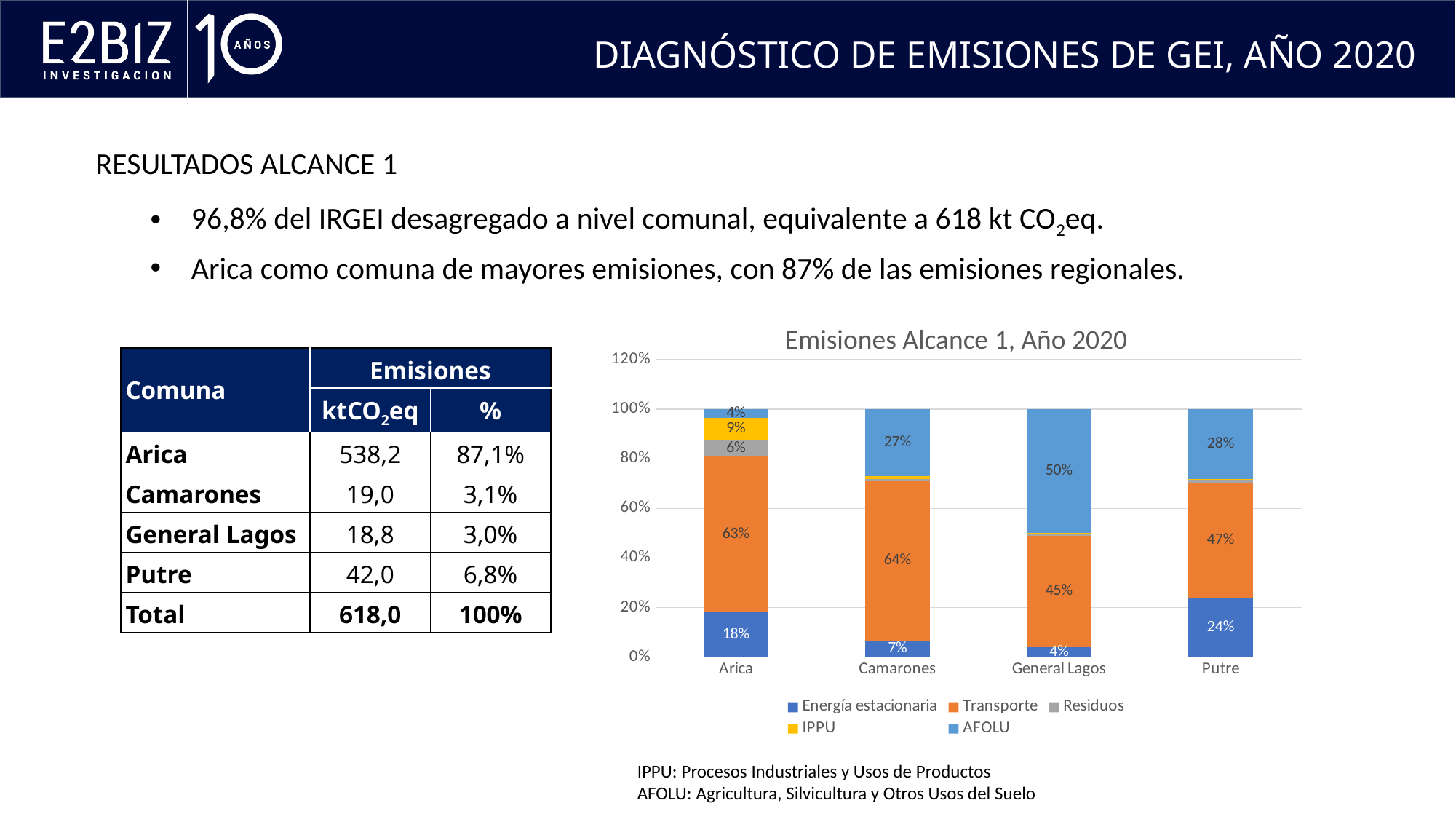
Which comuna has the highest Energía estacionaria share in the chart? Putre What is the Transporte share for Camarones in the chart? 64% How many comunas (categories) are shown on the x axis of the chart? 4 What is the difference between the AFOLU share for Putre and the AFOLU share for Camarones in the chart? 1% Which is larger in the chart: the Transporte share for Arica or the Transporte share for Putre? Arica What is the IPPU share for Arica in the chart? 9% How many series does the chart legend list? 5 Which comuna has the lowest Transporte share in the chart? General Lagos What is the Energía estacionaria share for Putre in the chart? 24% What type of chart is shown on the slide? Stacked bar chart What is the AFOLU share for General Lagos in the chart? 50% What is the title of the chart? Emisiones Alcance 1, Año 2020